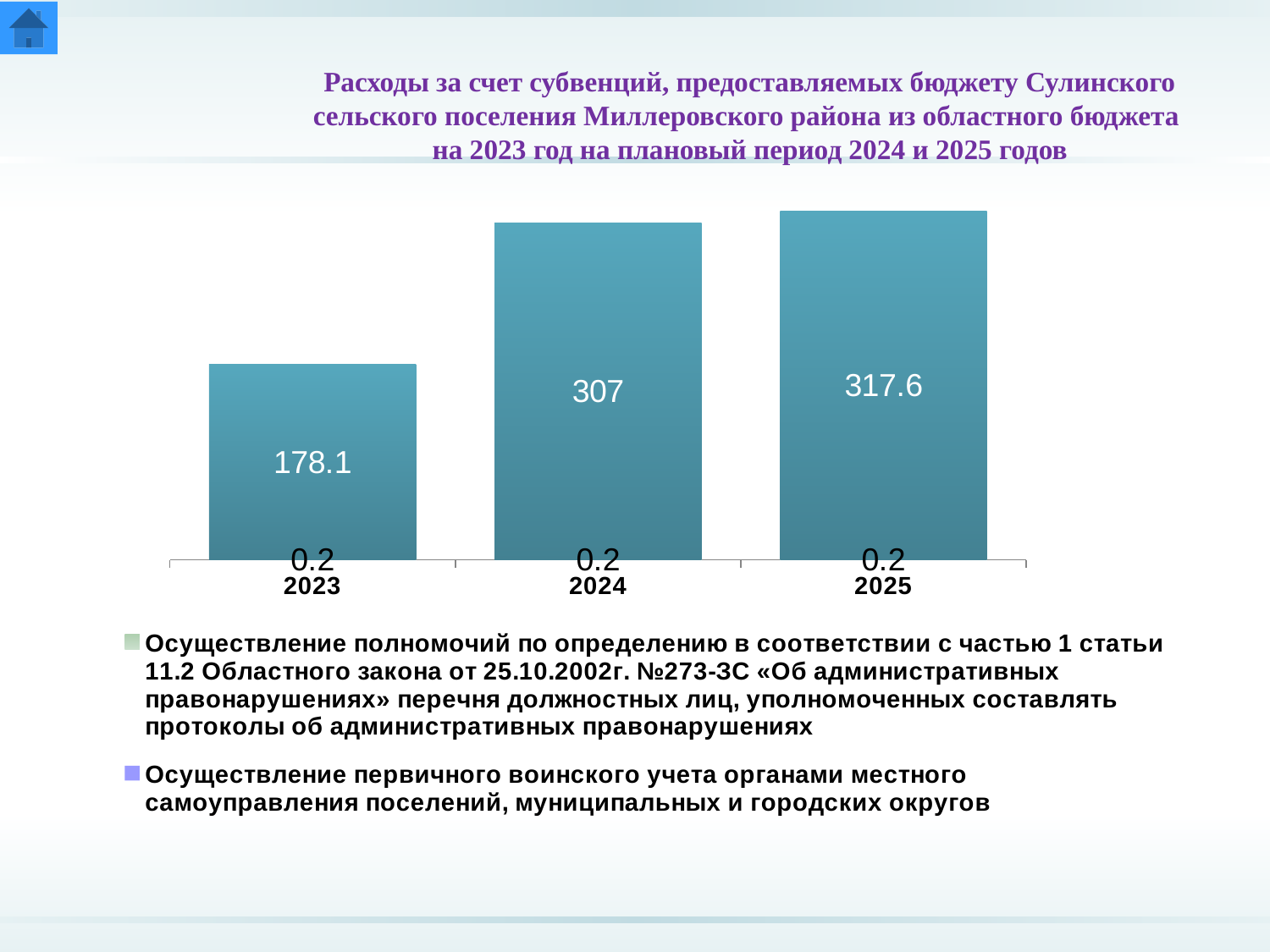
How many series does the legend list? 2 How many years are shown on the x axis? 3 In which year is the 'Осуществление первичного воинского учета' series highest? 2025 In which year is the 'Осуществление первичного воинского учета' series lowest? 2023 What is the difference between the 'Осуществление первичного воинского учета' values for 2024 and 2023? 128.9 What is the difference between the 'Осуществление первичного воинского учета' values for 2025 and 2024? 10.6 What is the value of the 'Осуществление полномочий по определению...' series for 2023? 0.2 What is the total of the stacked bar for 2023? 178.3 What is the value of the 'Осуществление первичного воинского учета' series for 2025? 317.6 What kind of chart is shown on the slide? Stacked bar chart What is the value of the 'Осуществление первичного воинского учета' series for 2023? 178.1 What is the value of the 'Осуществление первичного воинского учета' series for 2024? 307